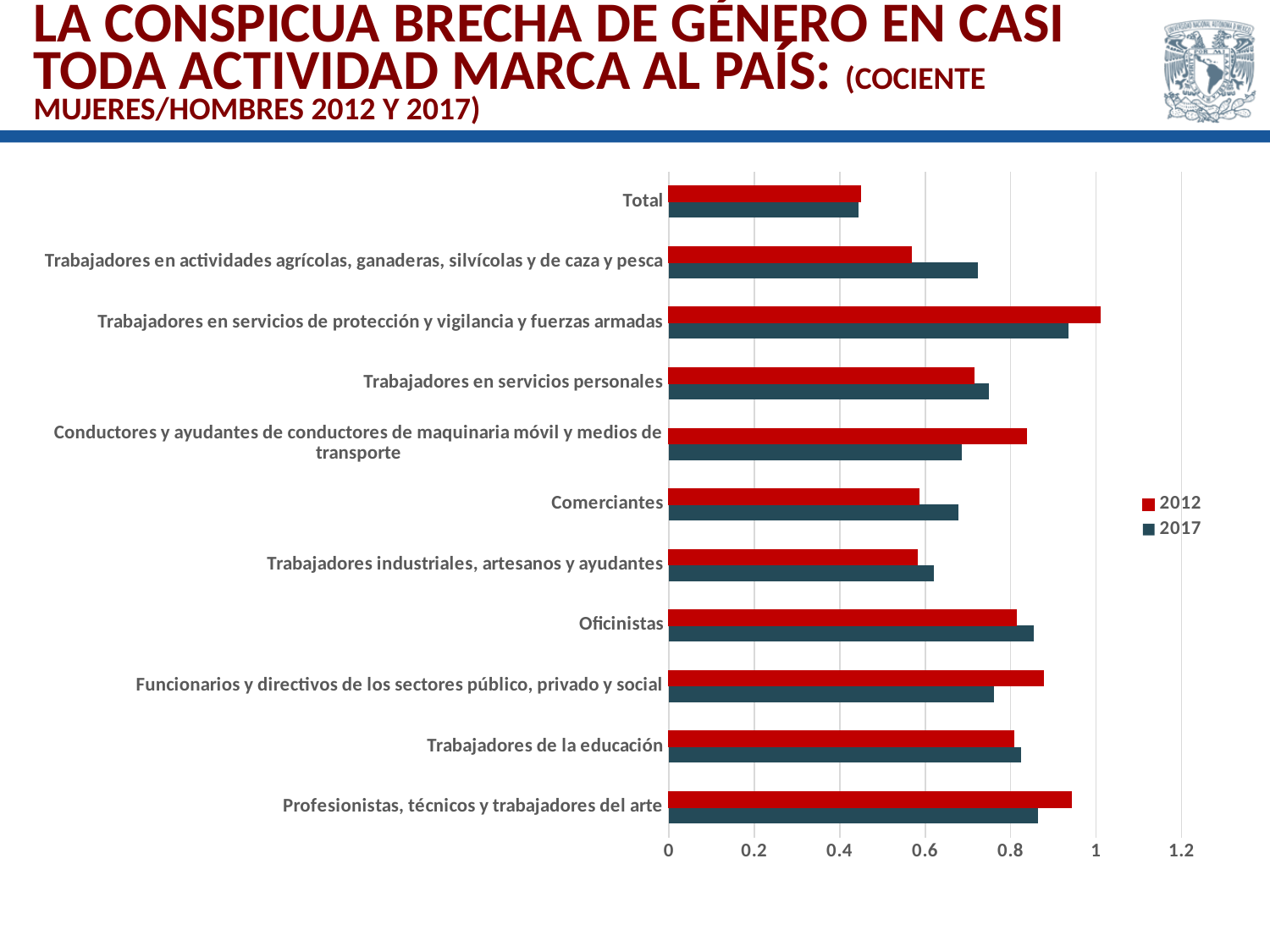
Which category has the lowest value for 2017? Total How many series does the legend list? 2 Which colour represents the 2012 series in the legend? red Is the 2017 value for Trabajadores en actividades agrícolas, ganaderas, silvícolas y de caza y pesca greater or less than 0.6? greater Which category has the highest value for 2012? Trabajadores en servicios de protección y vigilancia y fuerzas armadas What kind of chart is shown on the slide? bar chart For Conductores y ayudantes de conductores de maquinaria móvil y medios de transporte, which year has the larger value, 2012 or 2017? 2012 Is the 2012 value for Trabajadores en servicios de protección y vigilancia y fuerzas armadas greater or less than 0.8? greater How many categories are plotted on the vertical axis? 11 Is the 2017 value for Comerciantes greater or less than 0.6? greater For Trabajadores en actividades agrícolas, ganaderas, silvícolas y de caza y pesca, which year has the larger value, 2012 or 2017? 2017